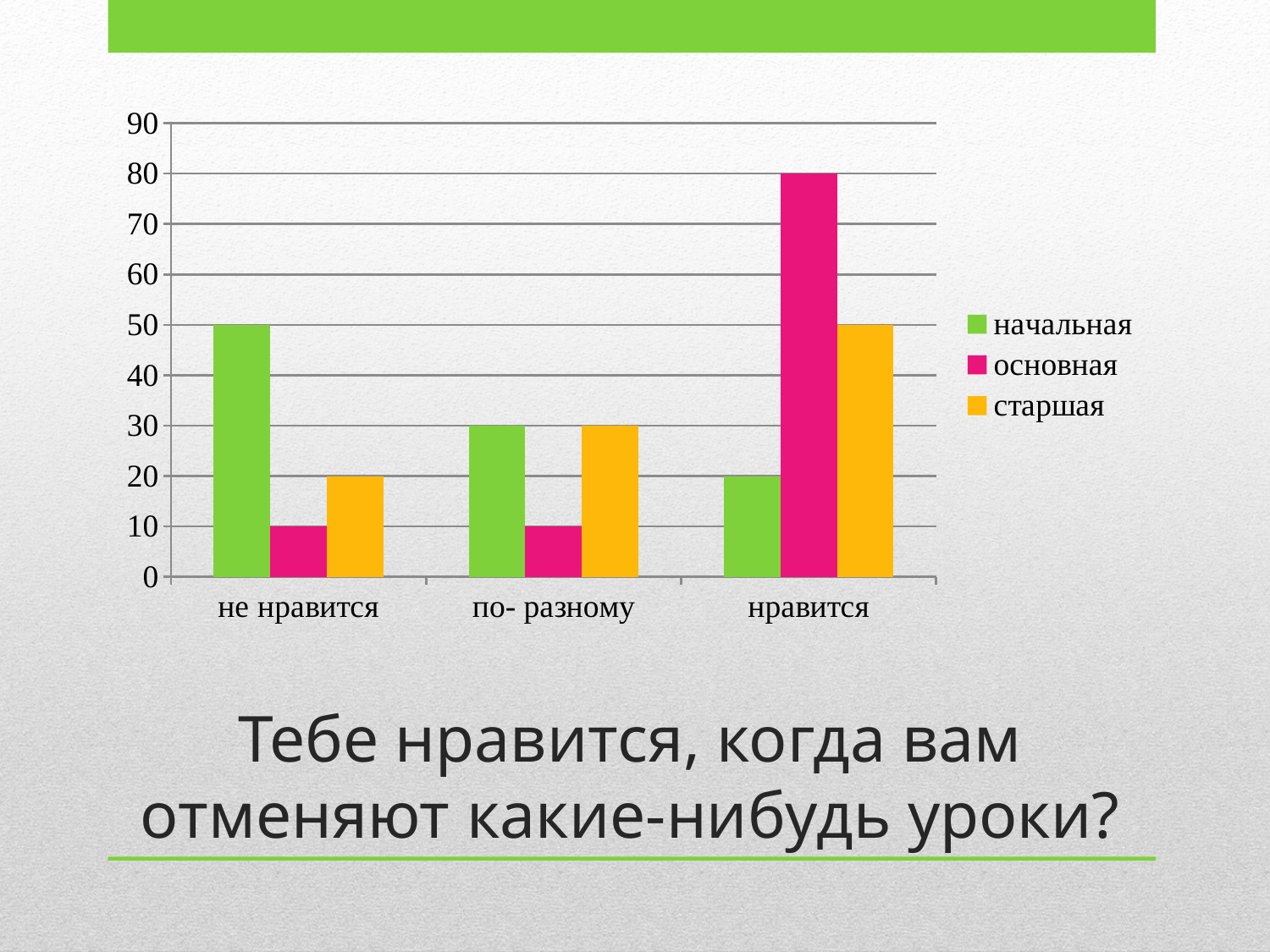
What is the value for начальная in the не нравится category? 50 Which category has the lowest value for начальная? нравится What is the difference between the основная and начальная values in the нравится category? 60 What type of chart is shown on the slide? bar chart Is the value for старшая in the нравится category greater or less than 40? greater What is the value for старшая in the по- разному category? 30 What is the value for основная in the нравится category? 80 Which series is shown in pink in the legend? основная How many categories are shown on the x axis? 3 Which category has the highest value for основная? нравится In the не нравится category, which is larger: the value for начальная or the value for старшая? начальная How many series does the legend list? 3